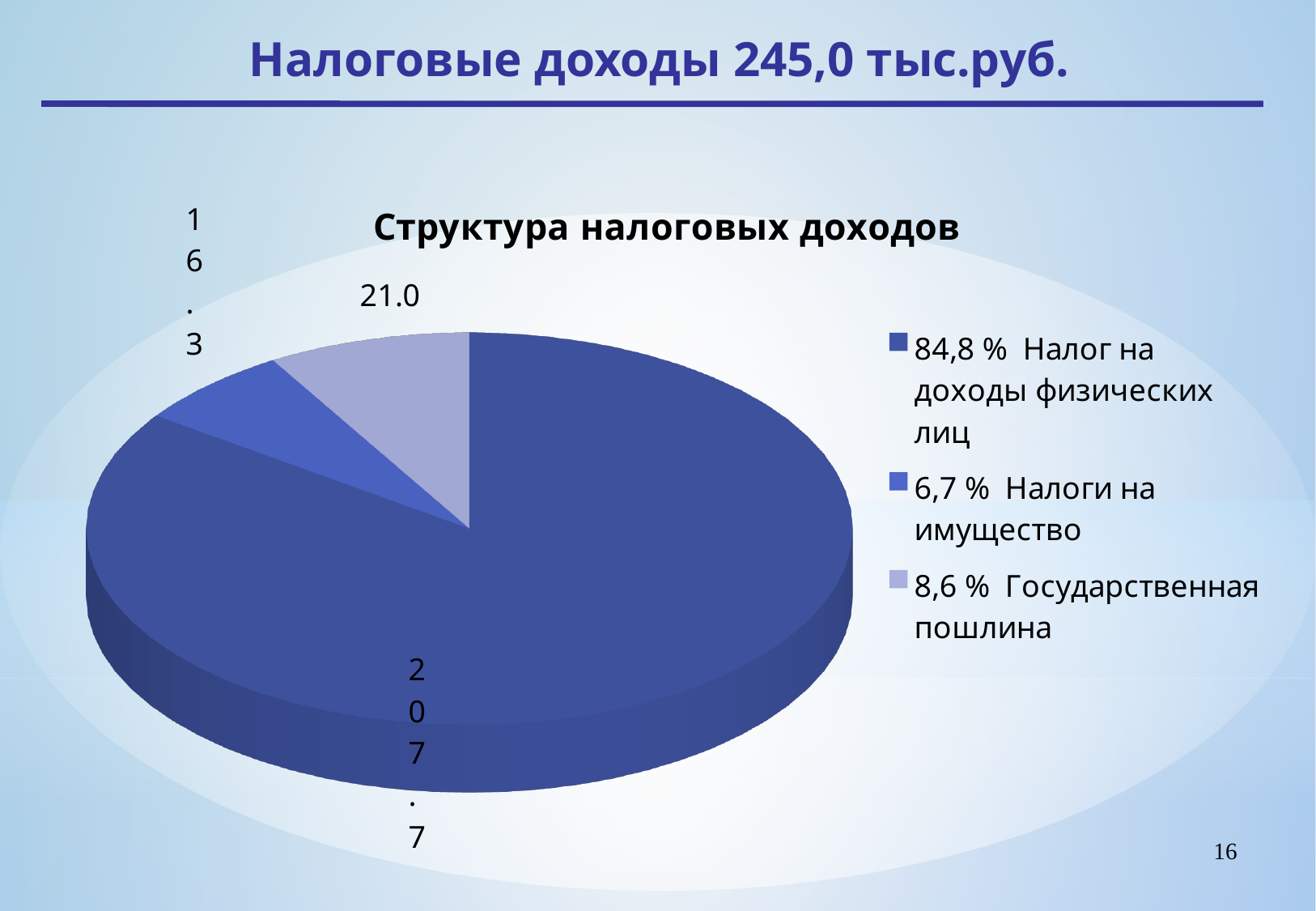
Which category has the largest slice of the pie? Налог на доходы физических лиц What value is labelled on the slice for Налог на доходы физических лиц? 207.7 What share of the pie does Налог на доходы физических лиц take, according to the legend? 84,8 % What is the difference between the values for Государственная пошлина and Налоги на имущество? 4.7 Which category has the smallest slice of the pie? Налоги на имущество What kind of chart is shown on the slide? pie chart What value is labelled on the slice for Государственная пошлина? 21.0 How many slices does the pie chart have? 3 Which is larger, the slice for Государственная пошлина or the slice for Налоги на имущество? Государственная пошлина How many entries does the legend list? 3 What value is labelled on the slice for Налоги на имущество? 16.3 What is the title of the chart? Структура налоговых доходов